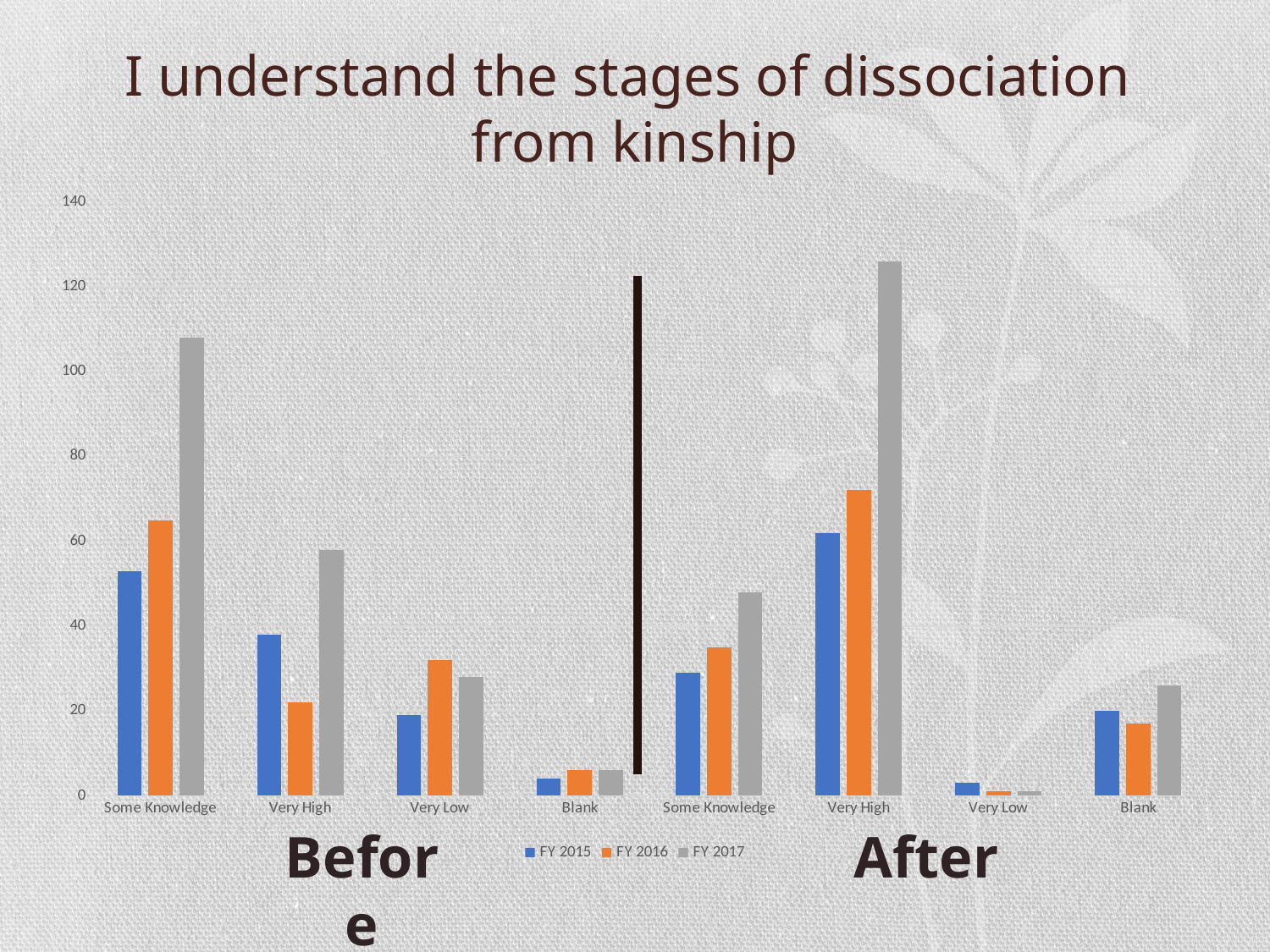
Is the FY 2015 value for 'Some Knowledge' on the Before side greater or less than 40? greater What kind of chart is shown on the slide? Bar chart Is the FY 2017 value for 'Some Knowledge' on the Before side greater or less than 100? greater How many categories are shown along the x axis of the chart? 8 How many series does the legend list? 3 What are the three series named in the chart legend? FY 2015, FY 2016, FY 2017 On the Before side, in the 'Very High' category, which is larger: FY 2015 or FY 2016? FY 2015 On the Before side, in the 'Very Low' category, which series has the lowest bar? FY 2015 Is the FY 2016 value for 'Very High' on the After side greater or less than 60? greater Which series has the tallest bar in the 'Very High' category on the After side of the chart? FY 2017 On the Before side, in the 'Some Knowledge' category, which is larger: FY 2015 or FY 2016? FY 2016